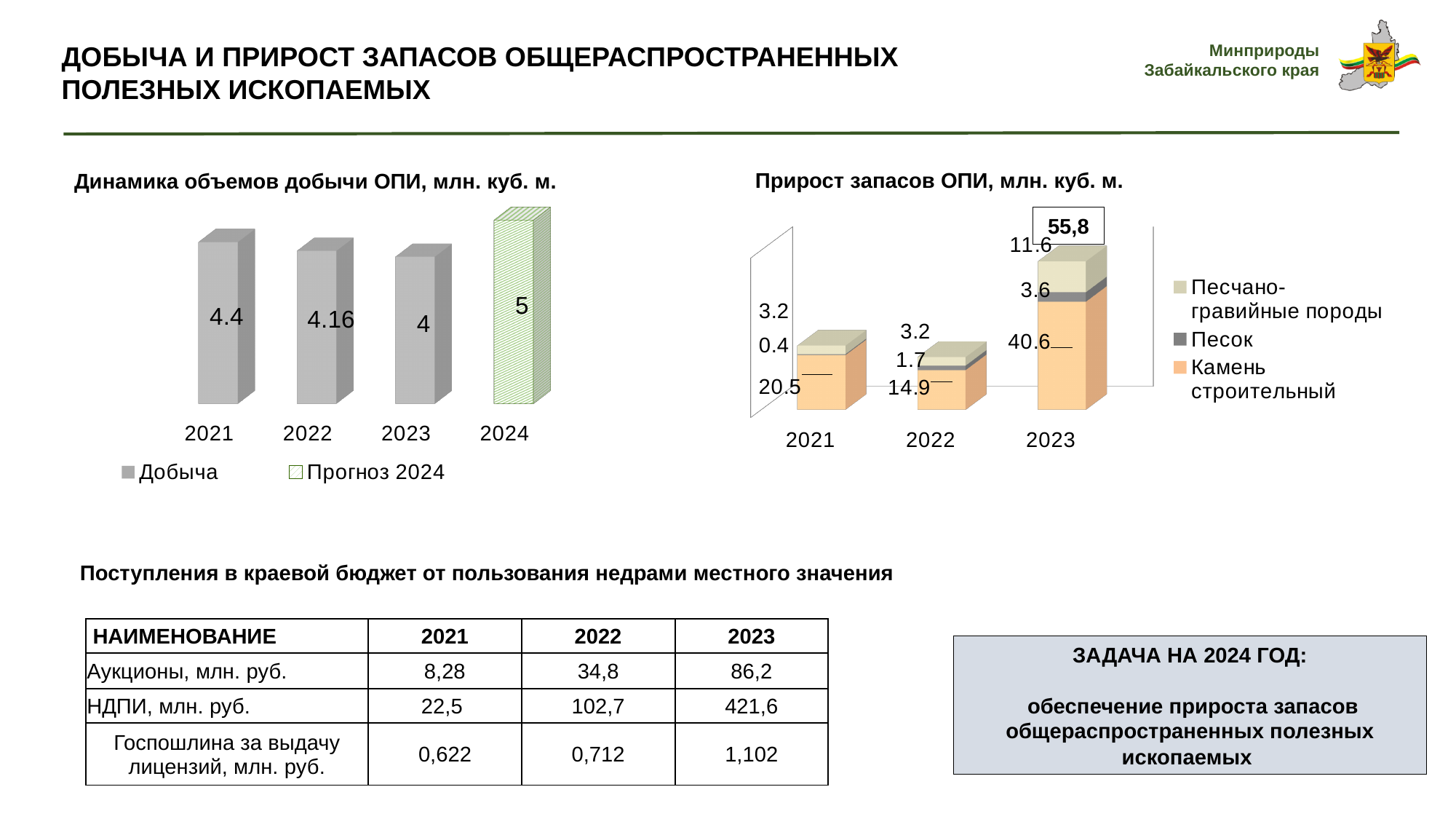
In the chart 'Динамика объемов добычи ОПИ, млн. куб. м.', what is the difference between the 2024 forecast and the 2023 value? 1 In the chart 'Прирост запасов ОПИ, млн. куб. м.', which is larger: 'Камень строительный' in 2021 or in 2022? 2021 In the chart 'Прирост запасов ОПИ, млн. куб. м.', what is the total of the stacked bar for 2023? 55,8 In the chart 'Динамика объемов добычи ОПИ, млн. куб. м.', how many entries does the legend list? 2 In the chart 'Прирост запасов ОПИ, млн. куб. м.', what is the total of the stacked bar for 2021? 24.1 In the chart 'Динамика объемов добычи ОПИ, млн. куб. м.', what is the value for 2021? 4.4 In the chart 'Динамика объемов добычи ОПИ, млн. куб. м.', what is the value for 2022? 4.16 In the chart 'Прирост запасов ОПИ, млн. куб. м.', what is the value of 'Камень строительный' for 2023? 40.6 What kind of chart is 'Прирост запасов ОПИ, млн. куб. м.'? stacked bar chart In the chart 'Динамика объемов добычи ОПИ, млн. куб. м.', do the values rise or fall from 2021 to 2023? fall In the chart 'Прирост запасов ОПИ, млн. куб. м.', what is the value of 'Песок' for 2022? 1.7 In the chart 'Динамика объемов добычи ОПИ, млн. куб. м.', which year has the lowest value among the actual (non-forecast) years? 2023